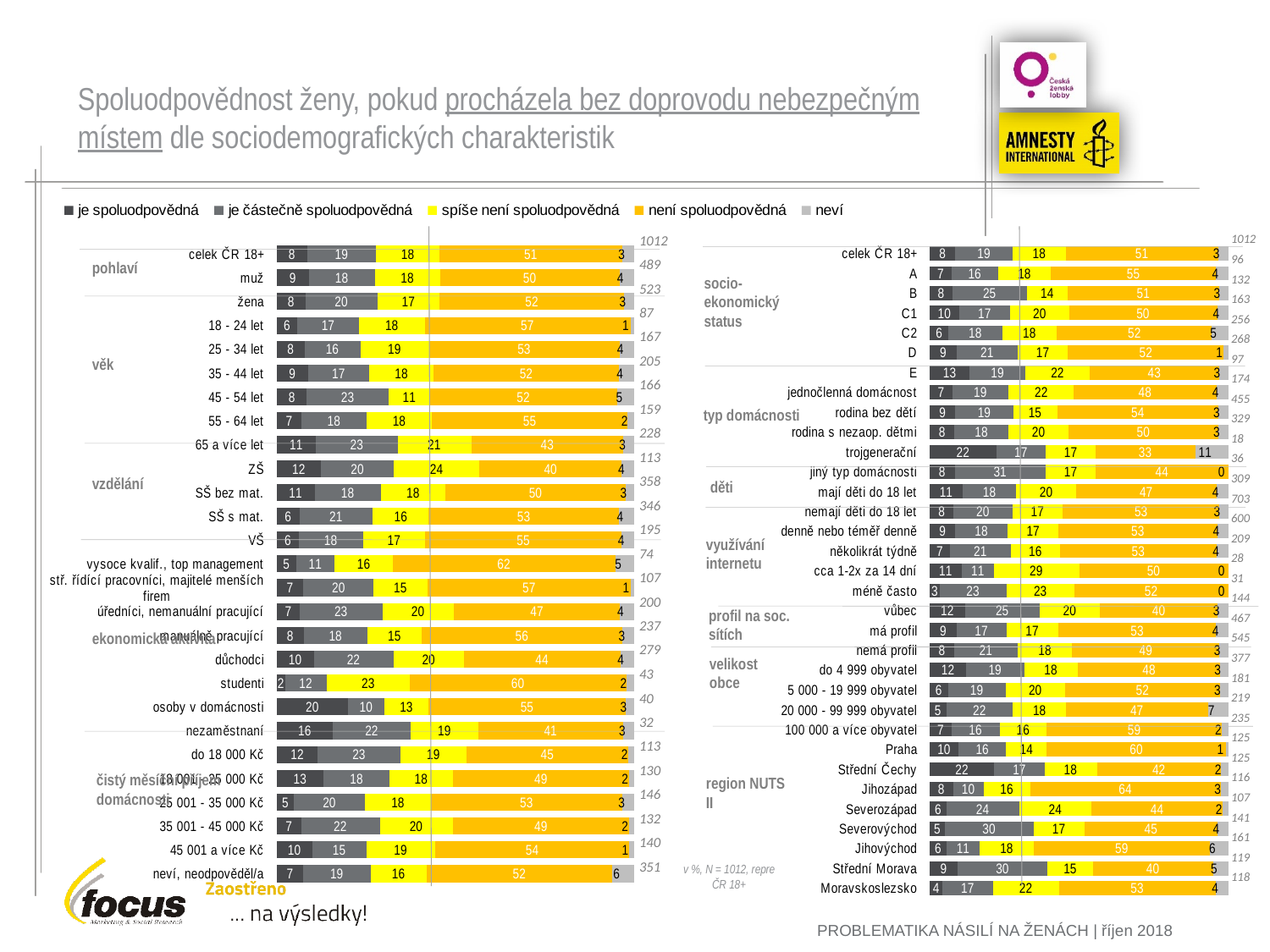
How many series does the legend list? 5 In the left chart, what is the value of 'není spoluodpovědná' for 'celek ČR 18+'? 51 In the right chart, what is the value of 'je částečně spoluodpovědná' for 'Severovýchod'? 30 In the left chart, what is the value of 'není spoluodpovědná' for 'vysoce kvalif., top management'? 62 In the right chart, what is the difference between 'není spoluodpovědná' for 'Praha' and for 'Střední Morava'? 20 In the left chart, what is the value of 'je spoluodpovědná' for 'nezaměstnaní'? 16 What type of chart is used on this slide? stacked bar chart In the right chart, what is the value of 'není spoluodpovědná' for 'Jihozápad'? 64 In the left chart, what is the value of 'spíše není spoluodpovědná' for 'ZŠ'? 24 In the left chart, which is larger: 'není spoluodpovědná' for 'muž' or for 'žena'? žena In the right chart, what is the value of 'neví' for 'trojgenerační'? 11 In the left chart, what is the difference between 'není spoluodpovědná' for '18 - 24 let' and for '65 a více let'? 14